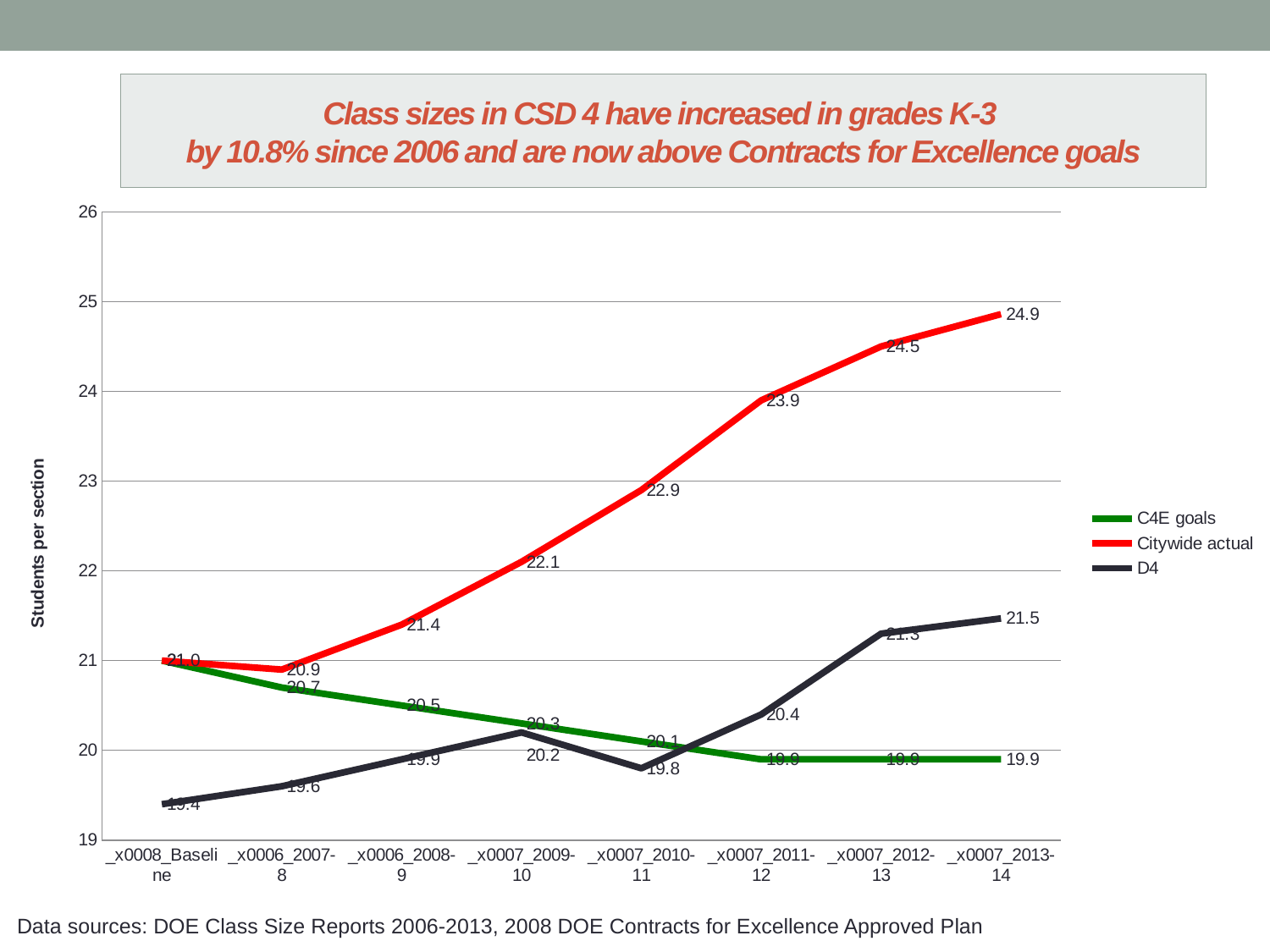
What is the title of the vertical axis? Students per section What is the D4 value at the Baseline? 19.4 What is the difference between the Citywide actual and D4 values in 2013-14? 3.4 What is the Citywide actual value for 2010-11? 22.9 What is the Citywide actual value for 2013-14? 24.9 What kind of chart is shown on the slide? line chart Which is larger in 2012-13, the D4 value or the C4E goals value? D4 Does the Citywide actual series rise or fall from 2007-8 to 2013-14? rise How many series does the legend list? 3 Which series has the highest value in 2013-14? Citywide actual What is the D4 value for 2013-14? 21.5 What is the C4E goals value for 2013-14? 19.9